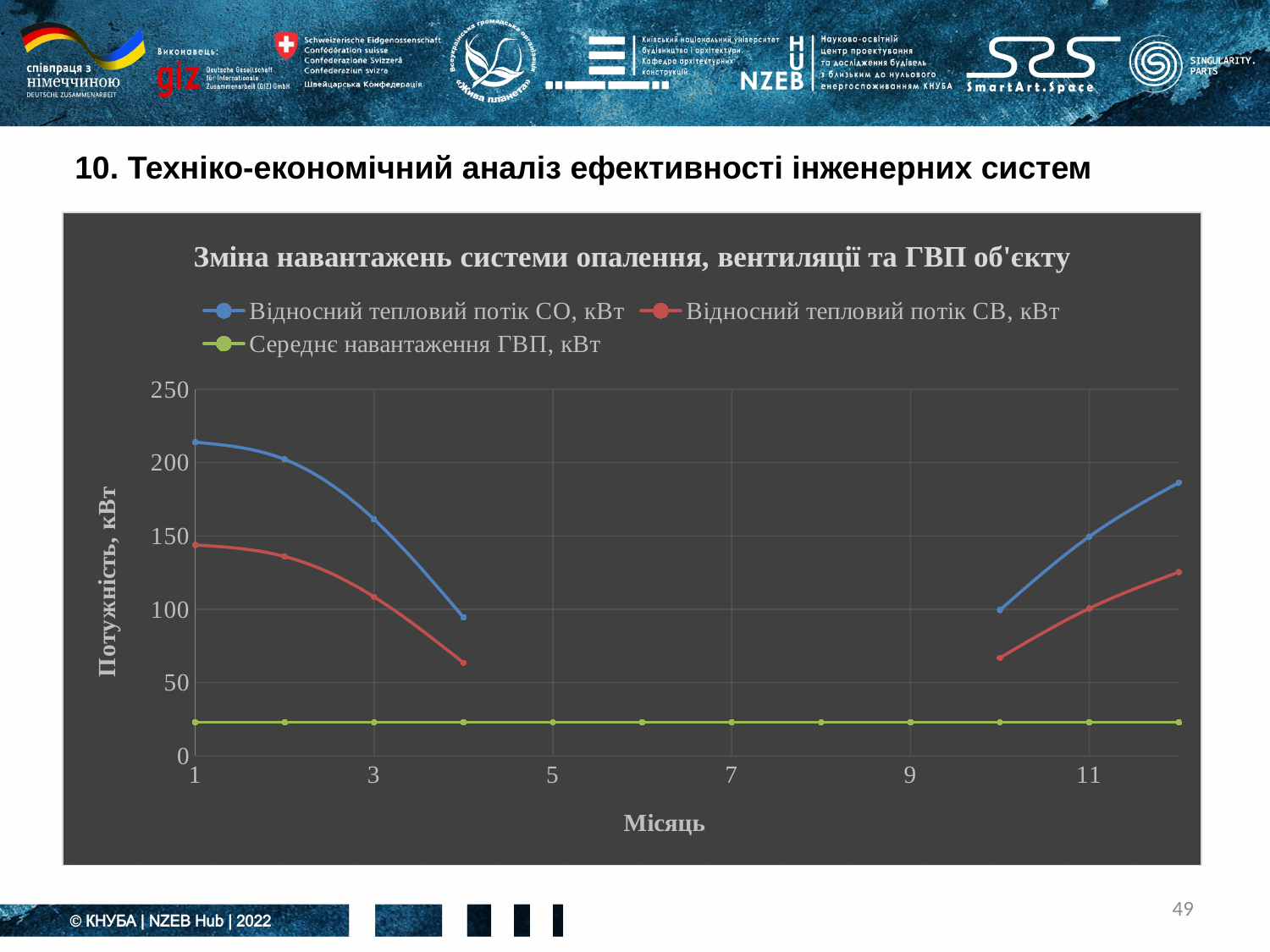
Is the value for 'Відносний тепловий потік СВ, кВт' at month 4 greater or less than 100? less What is the title of the chart? Зміна навантажень системи опалення, вентиляції та ГВП об'єкту At month 1, which series has the larger value: 'Відносний тепловий потік СО, кВт' or 'Відносний тепловий потік СВ, кВт'? Відносний тепловий потік СО, кВт Is the value for 'Відносний тепловий потік СО, кВт' at month 1 greater or less than 200? greater How many series does the legend list? 3 What is the label of the vertical axis? Потужність, кВт How many data points are plotted for 'Середнє навантаження ГВП, кВт'? 12 At which month does 'Відносний тепловий потік СО, кВт' reach its highest value? 1 What kind of chart is shown on the slide? line chart Does 'Відносний тепловий потік СО, кВт' rise or fall from month 1 to month 4? fall Is the value for 'Середнє навантаження ГВП, кВт' at month 6 greater or less than 50? less